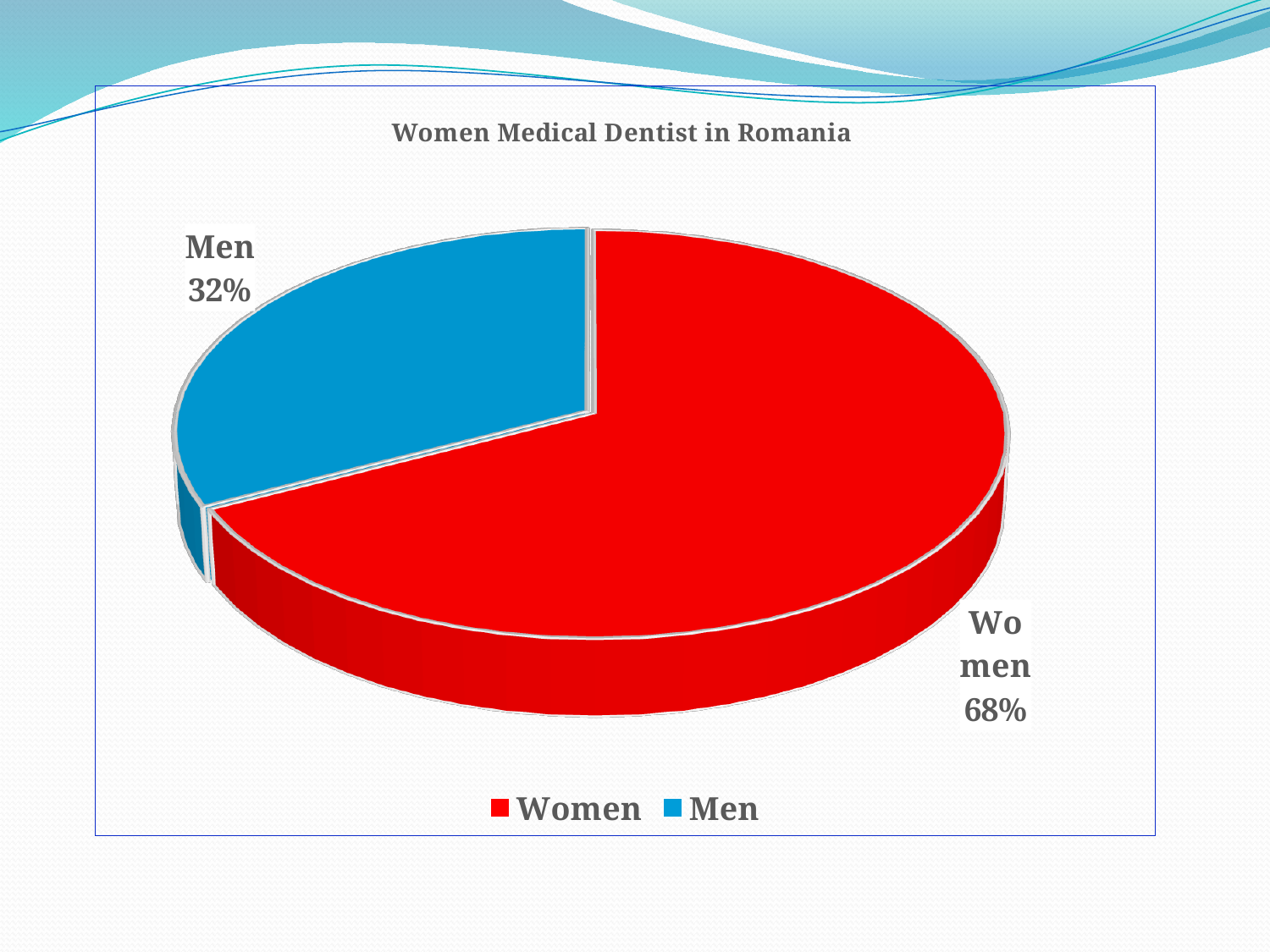
How many entries does the legend list? 2 How many slices does the pie chart have? 2 What is the title of the chart? Women Medical Dentist in Romania What is the difference in percentage points between the Women and Men slices? 36 What colour is the Men slice? blue Which slice is the largest? Women What share of the pie is Women? 68% What share of the pie is Men? 32% Is the value for Men greater or less than 50%? less What kind of chart is shown on the slide? pie chart Which slice is the smallest? Men Which is larger, the Women slice or the Men slice? Women